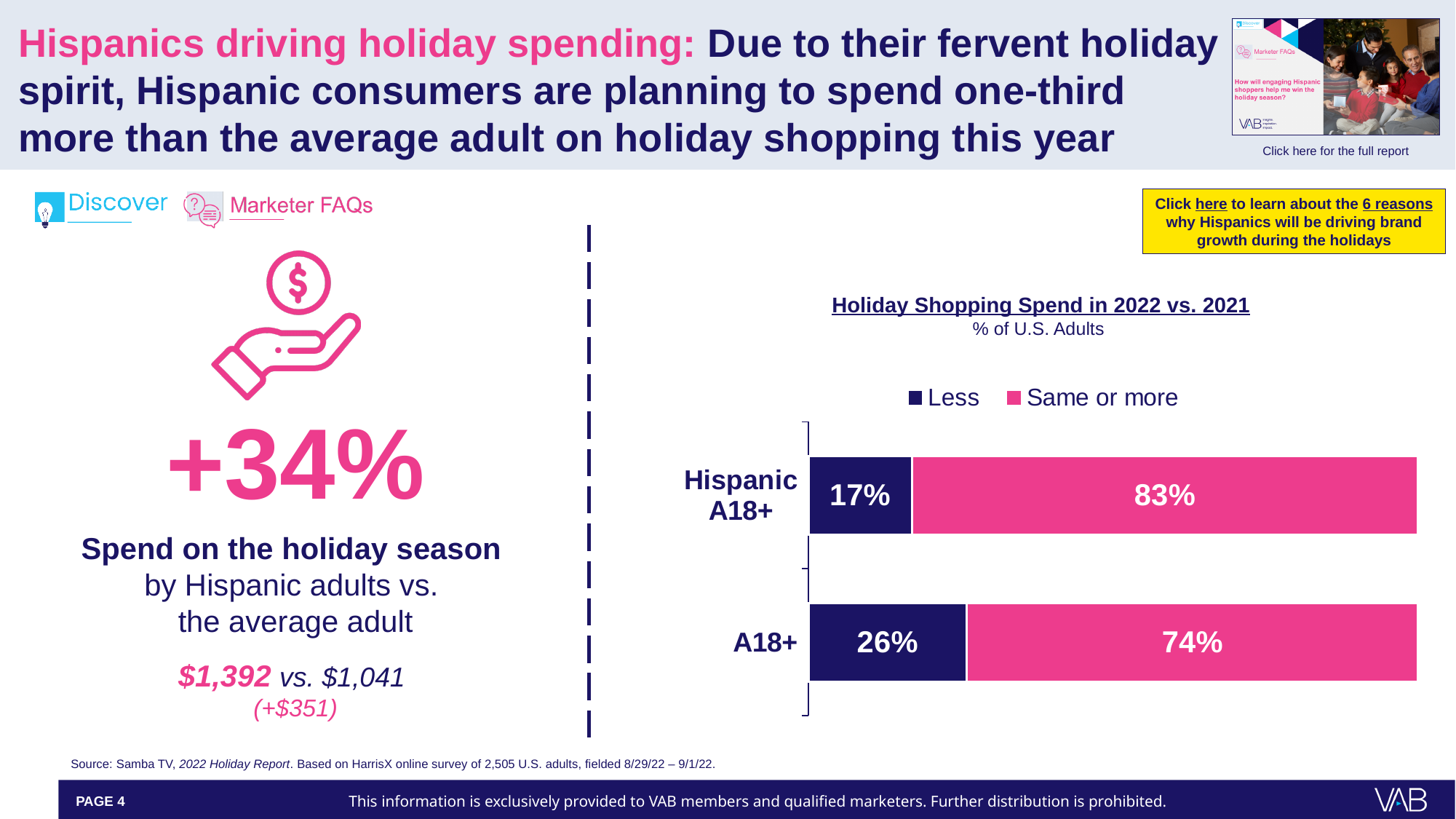
What is the difference in percentage points between the 'Same or more' share for Hispanic A18+ and for A18+? 9 percentage points What is the total of the stacked bar for Hispanic A18+? 100% What is the difference in percentage points between the 'Less' share for A18+ and for Hispanic A18+? 9 percentage points What type of chart is used to show Holiday Shopping Spend in 2022 vs. 2021? Stacked bar chart What percentage of Hispanic A18+ adults plan to spend less on holiday shopping in 2022 vs. 2021? 17% Which group has the higher share planning to spend less: Hispanic A18+ or A18+? A18+ What percentage of A18+ adults plan to spend less on holiday shopping in 2022 vs. 2021? 26% Which group has the higher share planning to spend the same or more: Hispanic A18+ or A18+? Hispanic A18+ What percentage of A18+ adults plan to spend the same or more on holiday shopping in 2022 vs. 2021? 74% What percentage of Hispanic A18+ adults plan to spend the same or more on holiday shopping in 2022 vs. 2021? 83% How many groups (categories) are shown in the chart? 2 How many series does the chart legend list? 2